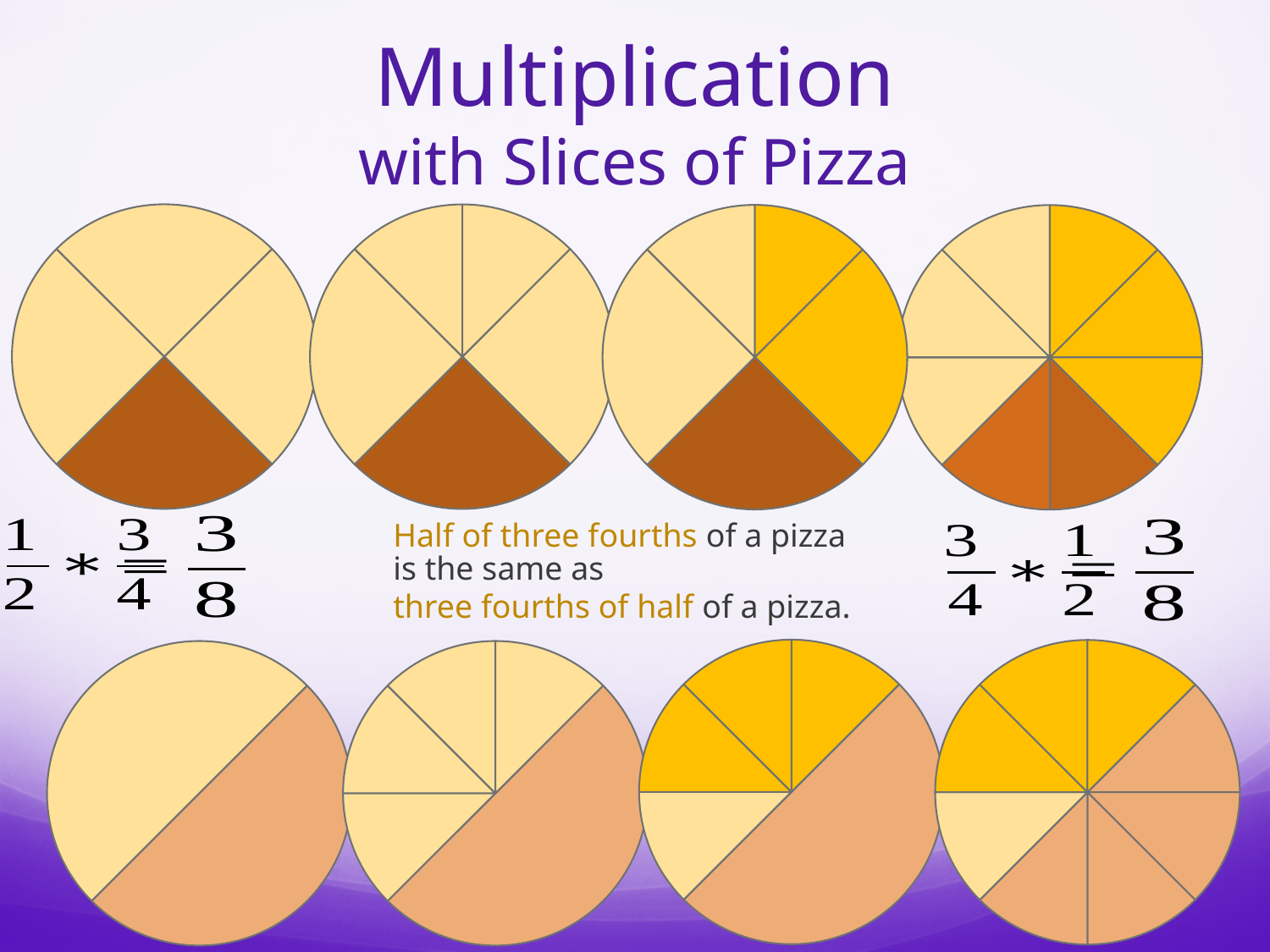
According to the equation on the right, what is 3/4 * 1/2? 3/8 How many pizza pie diagrams are shown on the slide? 8 What kind of chart is used to show the pizzas on this slide? pie chart According to the equation on the left, what is 1/2 * 3/4? 3/8 How many slices is the bottom-right pizza divided into? 8 How many slices is the bottom-left pizza divided into? 2 What is the title of the slide? Multiplication with Slices of Pizza